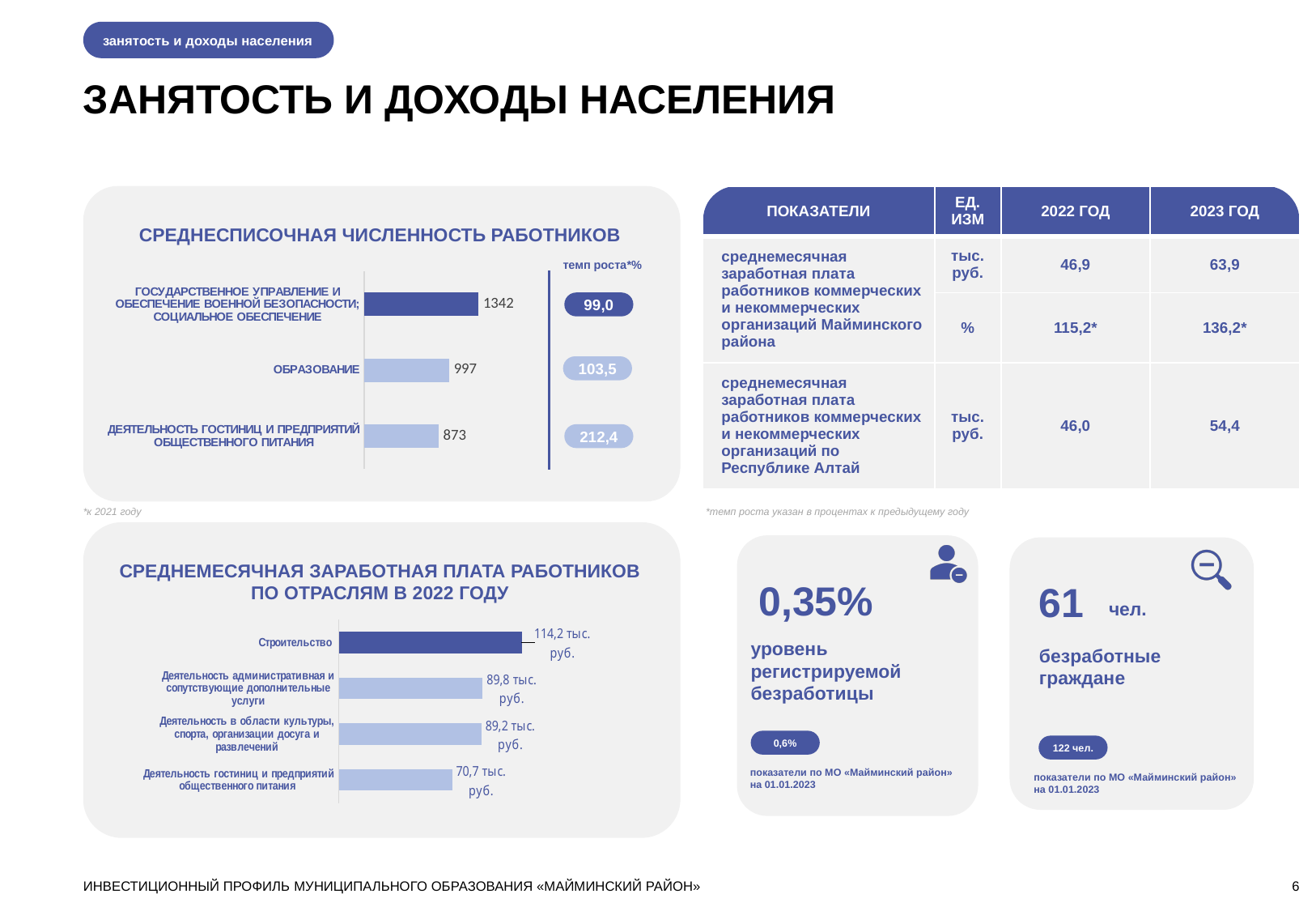
On the chart 'СРЕДНЕСПИСОЧНАЯ ЧИСЛЕННОСТЬ РАБОТНИКОВ', how many categories are shown? 3 On the chart 'СРЕДНЕСПИСОЧНАЯ ЧИСЛЕННОСТЬ РАБОТНИКОВ', which category has the highest value? ГОСУДАРСТВЕННОЕ УПРАВЛЕНИЕ И ОБЕСПЕЧЕНИЕ ВОЕННОЙ БЕЗОПАСНОСТИ; СОЦИАЛЬНОЕ ОБЕСПЕЧЕНИЕ What kind of chart is 'СРЕДНЕМЕСЯЧНАЯ ЗАРАБОТНАЯ ПЛАТА РАБОТНИКОВ ПО ОТРАСЛЯМ В 2022 ГОДУ'? Bar chart On the chart 'СРЕДНЕМЕСЯЧНАЯ ЗАРАБОТНАЯ ПЛАТА РАБОТНИКОВ ПО ОТРАСЛЯМ В 2022 ГОДУ', what is the value for Строительство? 114,2 тыс. руб. On the chart 'СРЕДНЕМЕСЯЧНАЯ ЗАРАБОТНАЯ ПЛАТА РАБОТНИКОВ ПО ОТРАСЛЯМ В 2022 ГОДУ', how many categories are shown? 4 On the chart 'СРЕДНЕСПИСОЧНАЯ ЧИСЛЕННОСТЬ РАБОТНИКОВ', what is the темп роста value shown for ДЕЯТЕЛЬНОСТЬ ГОСТИНИЦ И ПРЕДПРИЯТИЙ ОБЩЕСТВЕННОГО ПИТАНИЯ? 212,4 On the chart 'СРЕДНЕСПИСОЧНАЯ ЧИСЛЕННОСТЬ РАБОТНИКОВ', what is the difference between the values for ГОСУДАРСТВЕННОЕ УПРАВЛЕНИЕ И ОБЕСПЕЧЕНИЕ ВОЕННОЙ БЕЗОПАСНОСТИ; СОЦИАЛЬНОЕ ОБЕСПЕЧЕНИЕ and ОБРАЗОВАНИЕ? 345 On the chart 'СРЕДНЕСПИСОЧНАЯ ЧИСЛЕННОСТЬ РАБОТНИКОВ', what is the value for ОБРАЗОВАНИЕ? 997 On the chart 'СРЕДНЕМЕСЯЧНАЯ ЗАРАБОТНАЯ ПЛАТА РАБОТНИКОВ ПО ОТРАСЛЯМ В 2022 ГОДУ', what is the difference between the values for Строительство and Деятельность гостиниц и предприятий общественного питания? 43,5 тыс. руб. On the chart 'СРЕДНЕМЕСЯЧНАЯ ЗАРАБОТНАЯ ПЛАТА РАБОТНИКОВ ПО ОТРАСЛЯМ В 2022 ГОДУ', what is the value for Деятельность в области культуры, спорта, организации досуга и развлечений? 89,2 тыс. руб. On the chart 'СРЕДНЕМЕСЯЧНАЯ ЗАРАБОТНАЯ ПЛАТА РАБОТНИКОВ ПО ОТРАСЛЯМ В 2022 ГОДУ', which category has the lowest value? Деятельность гостиниц и предприятий общественного питания On the chart 'СРЕДНЕСПИСОЧНАЯ ЧИСЛЕННОСТЬ РАБОТНИКОВ', what is the value for ДЕЯТЕЛЬНОСТЬ ГОСТИНИЦ И ПРЕДПРИЯТИЙ ОБЩЕСТВЕННОГО ПИТАНИЯ? 873